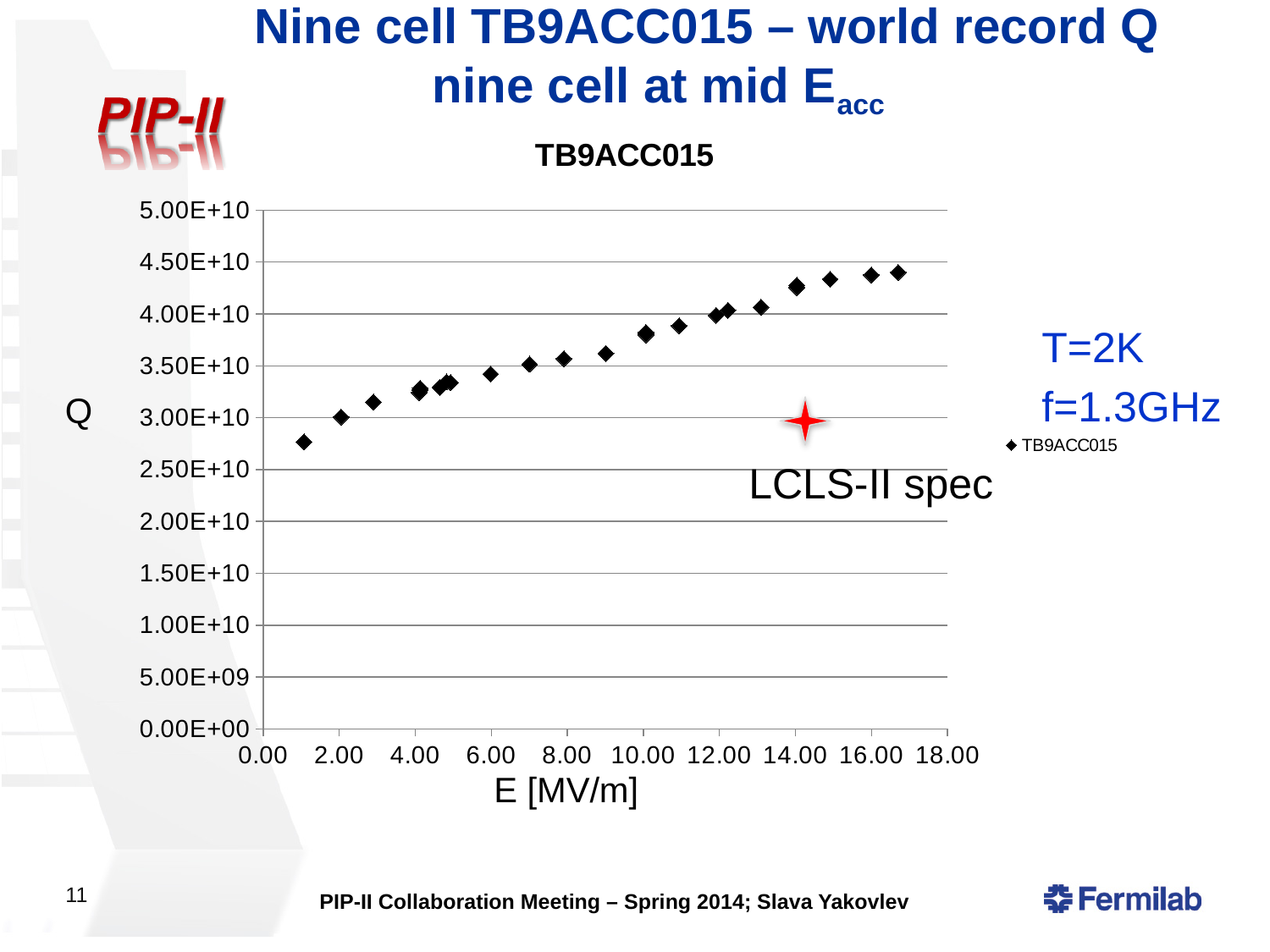
Is the Q value at about E = 2 MV/m greater or less than 3.50E+10? less Is the Q value at about E = 14 MV/m greater or less than 4.00E+10? greater Is the Q value of the rightmost data point (near E = 17 MV/m) greater or less than 4.00E+10? greater What is the label of the x axis of the chart? E [MV/m] How many series does the chart legend list? 1 What is the title of the chart? TB9ACC015 Which data point has the highest Q value, the one at the lowest E or the one at the highest E? The one at the highest E Do the Q values rise or fall as E increases along the x axis? Rise What kind of chart is shown on the slide? Scatter chart